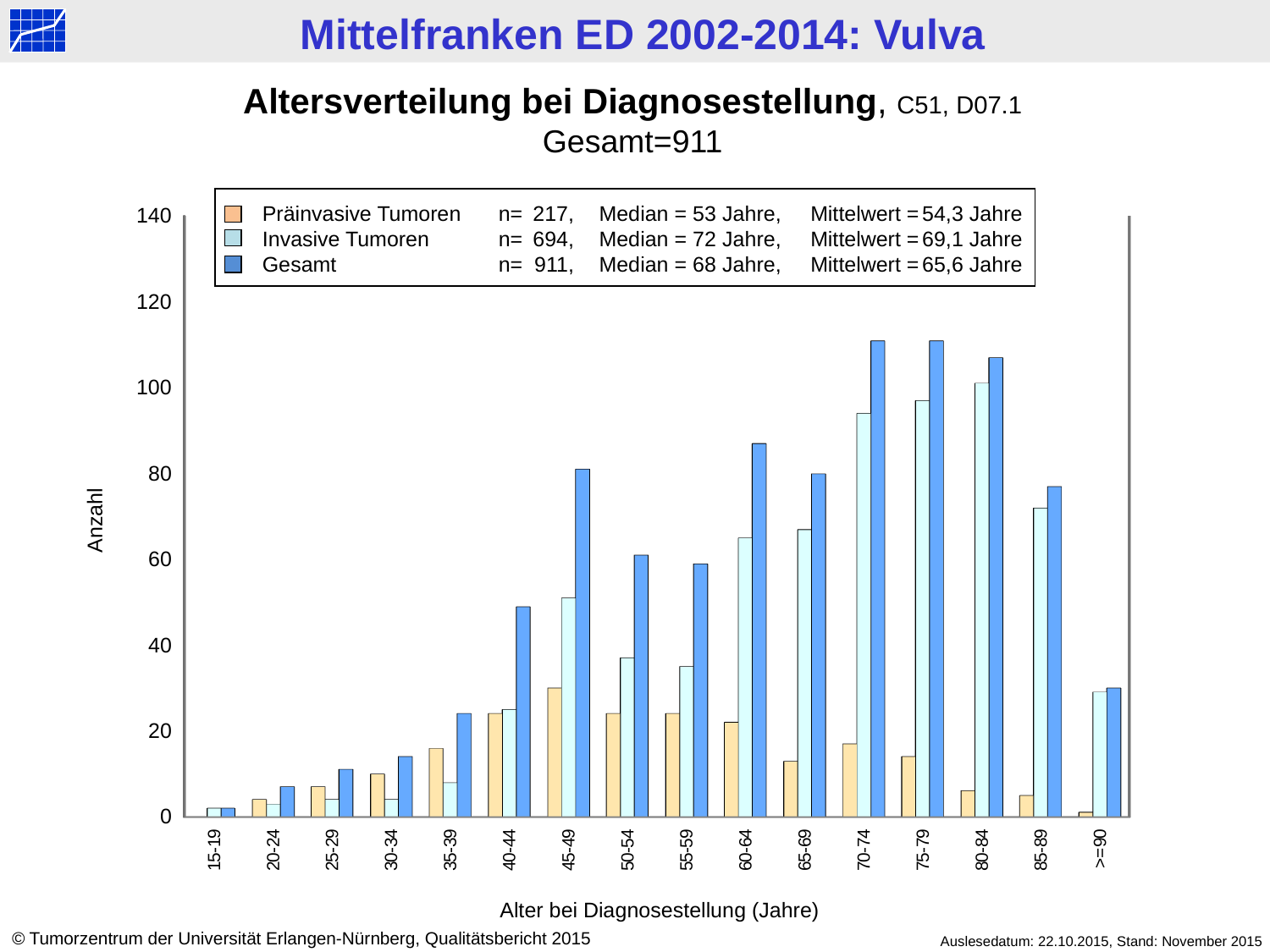
What kind of chart is shown on the slide? bar chart Which is larger for Präinvasive Tumoren: the value for 35-39 or the value for 40-44? 40-44 How many age categories are shown on the x axis? 16 Which is larger for Gesamt: the value for 60-64 or the value for 65-69? 60-64 Is the Gesamt value for 40-44 greater or less than 40? greater Is the Präinvasive Tumoren value for 45-49 greater or less than 20? greater Which age category has the highest value for Präinvasive Tumoren? 45-49 Is the Invasive Tumoren value for 85-89 greater or less than 60? greater How many series does the legend list? 3 Which age category has the lowest value for Gesamt? 15-19 According to the legend, what is the n for Invasive Tumoren? 694